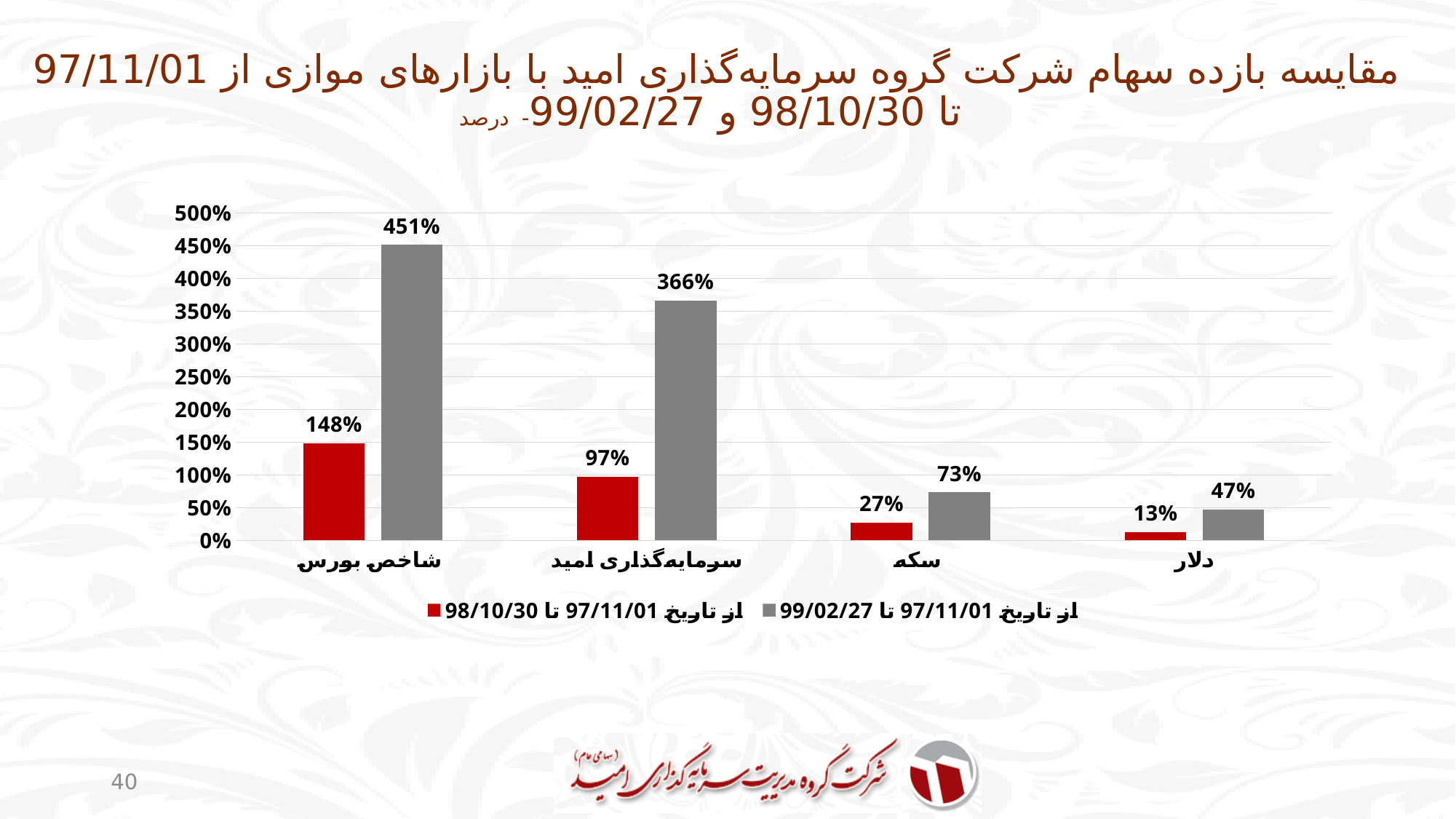
What colour are the bars for the series از تاریخ 97/11/01 تا 98/10/30? Red What kind of chart is shown on the slide? Bar chart What is the difference between the two series values for سرمایه‌گذاری امید? 269% What is the value for سکه in the series از تاریخ 97/11/01 تا 98/10/30? 27% How many categories are shown on the x axis? 4 Which is larger: the value for سکه in the series از تاریخ 97/11/01 تا 99/02/27 or the value for شاخص بورس in the series از تاریخ 97/11/01 تا 98/10/30? شاخص بورس in the series از تاریخ 97/11/01 تا 98/10/30 Which category has the lowest value in the series از تاریخ 97/11/01 تا 98/10/30? دلار What is the value for دلار in the series از تاریخ 97/11/01 تا 99/02/27? 47% How many series does the legend list? 2 What is the value for سرمایه‌گذاری امید in the series از تاریخ 97/11/01 تا 98/10/30? 97% Which category has the highest value in the series از تاریخ 97/11/01 تا 99/02/27? شاخص بورس What is the value for شاخص بورس in the series از تاریخ 97/11/01 تا 99/02/27? 451%